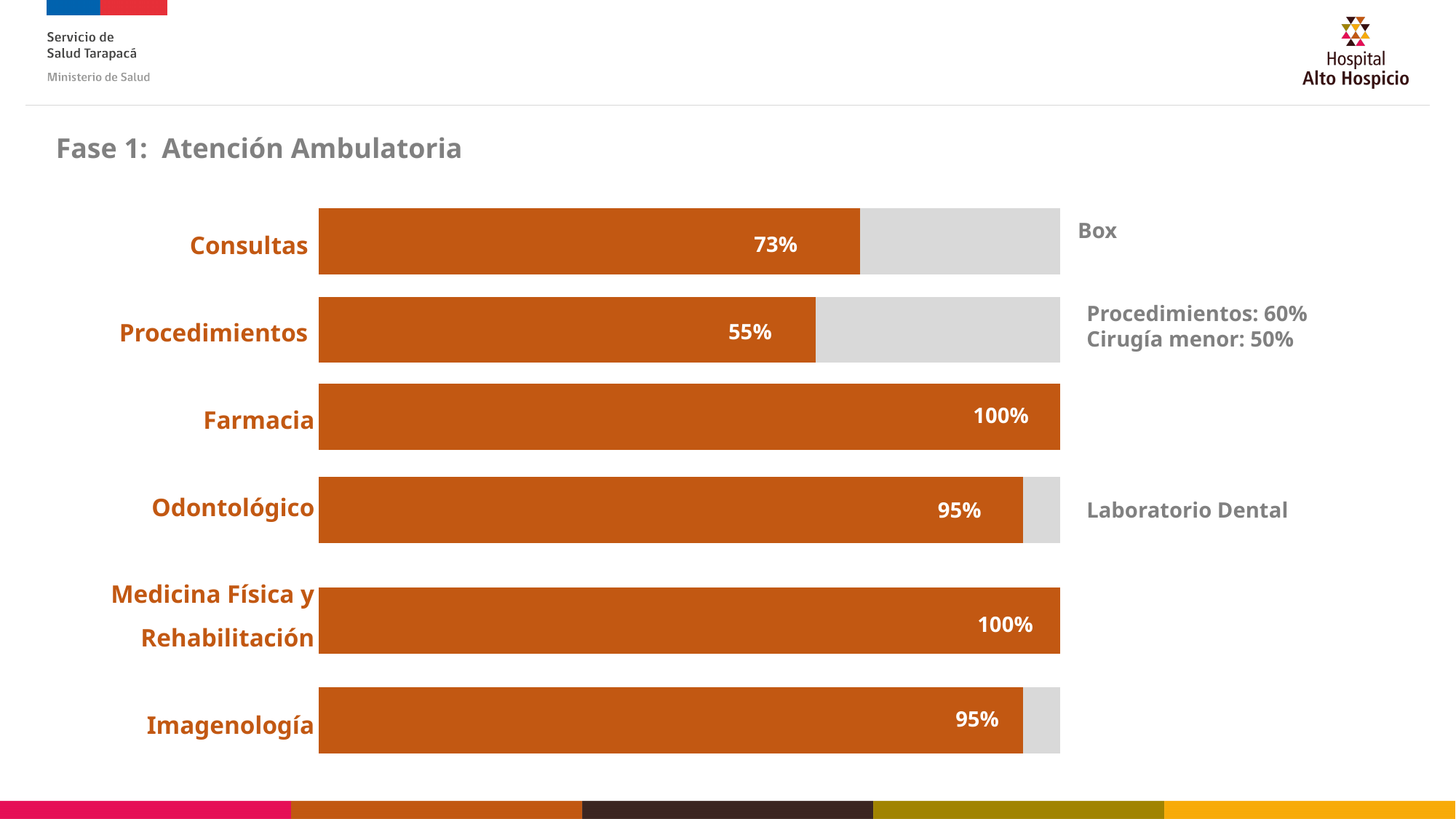
What is the value for Procedimientos? 55% What is the difference between the values for Consultas and Procedimientos? 18% What is the value for Consultas? 73% Which category has the lowest value? Procedimientos Which is larger, the value for Consultas or the value for Odontológico? Odontológico How many categories are shown in the chart? 6 Which categories reach 100%? Farmacia and Medicina Física y Rehabilitación What is the value for Odontológico? 95% What is the title of the slide containing the chart? Fase 1: Atención Ambulatoria What is the value for Imagenología? 95% What is the difference between the values for Farmacia and Odontológico? 5% What kind of chart is shown on the slide? Bar chart